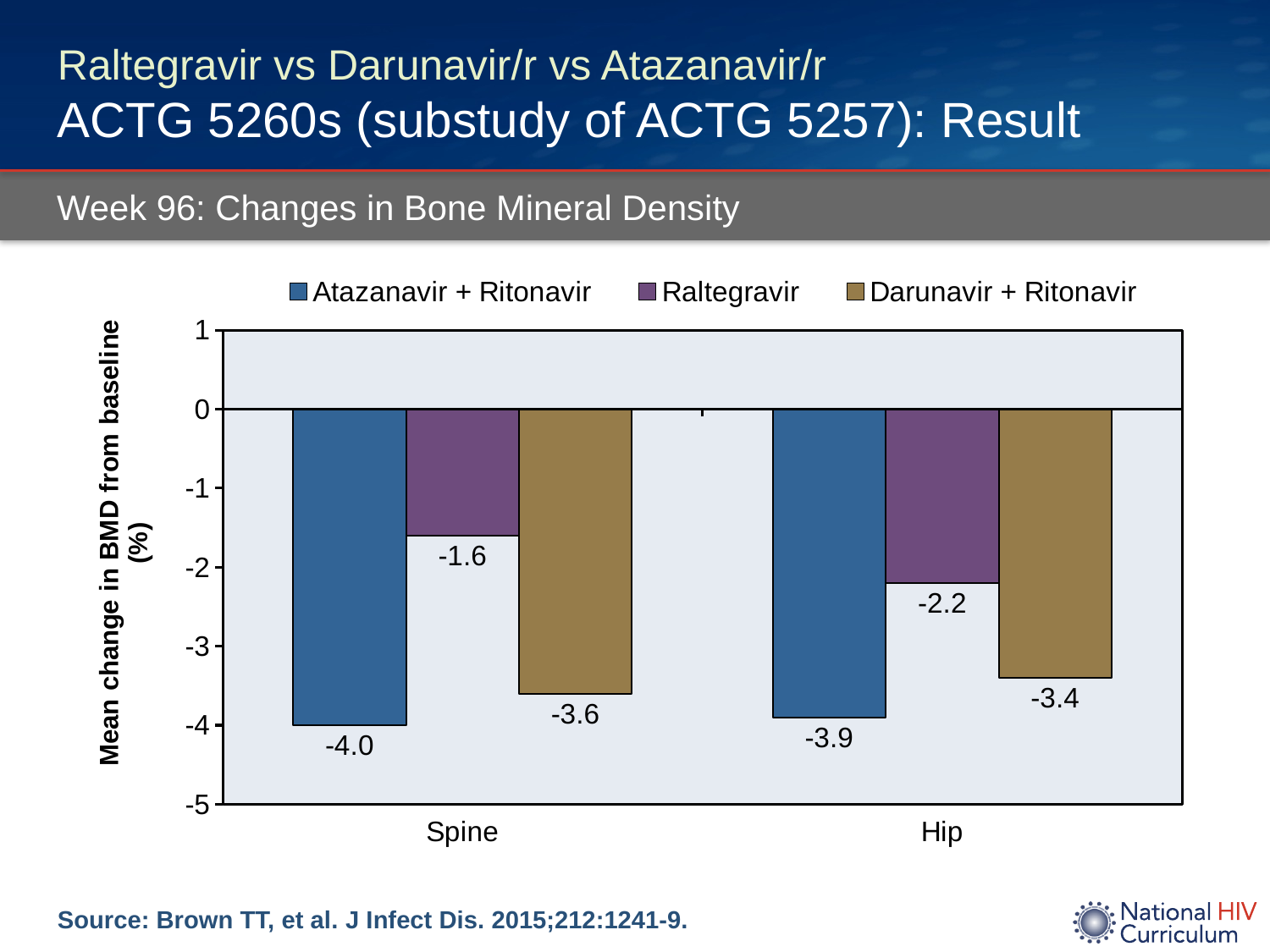
What is the mean change in BMD from baseline for Darunavir + Ritonavir at the Spine? -3.6 What is the mean change in BMD from baseline for Raltegravir at the Hip? -2.2 How many series does the legend list? 3 What kind of chart is shown on the slide? Bar chart What is the mean change in BMD from baseline for Atazanavir + Ritonavir at the Spine? -4.0 Which treatment shows the smallest decrease in BMD at the Spine? Raltegravir Which has a larger decrease in BMD at the Hip: Raltegravir or Darunavir + Ritonavir? Darunavir + Ritonavir What is the difference between the Spine values for Atazanavir + Ritonavir and Raltegravir? 2.4 Which treatment shows the largest decrease in BMD at the Hip? Atazanavir + Ritonavir What is the difference between the Hip values for Darunavir + Ritonavir and Raltegravir? 1.2 How many categories are shown on the x axis? 2 What is the mean change in BMD from baseline for Atazanavir + Ritonavir at the Hip? -3.9